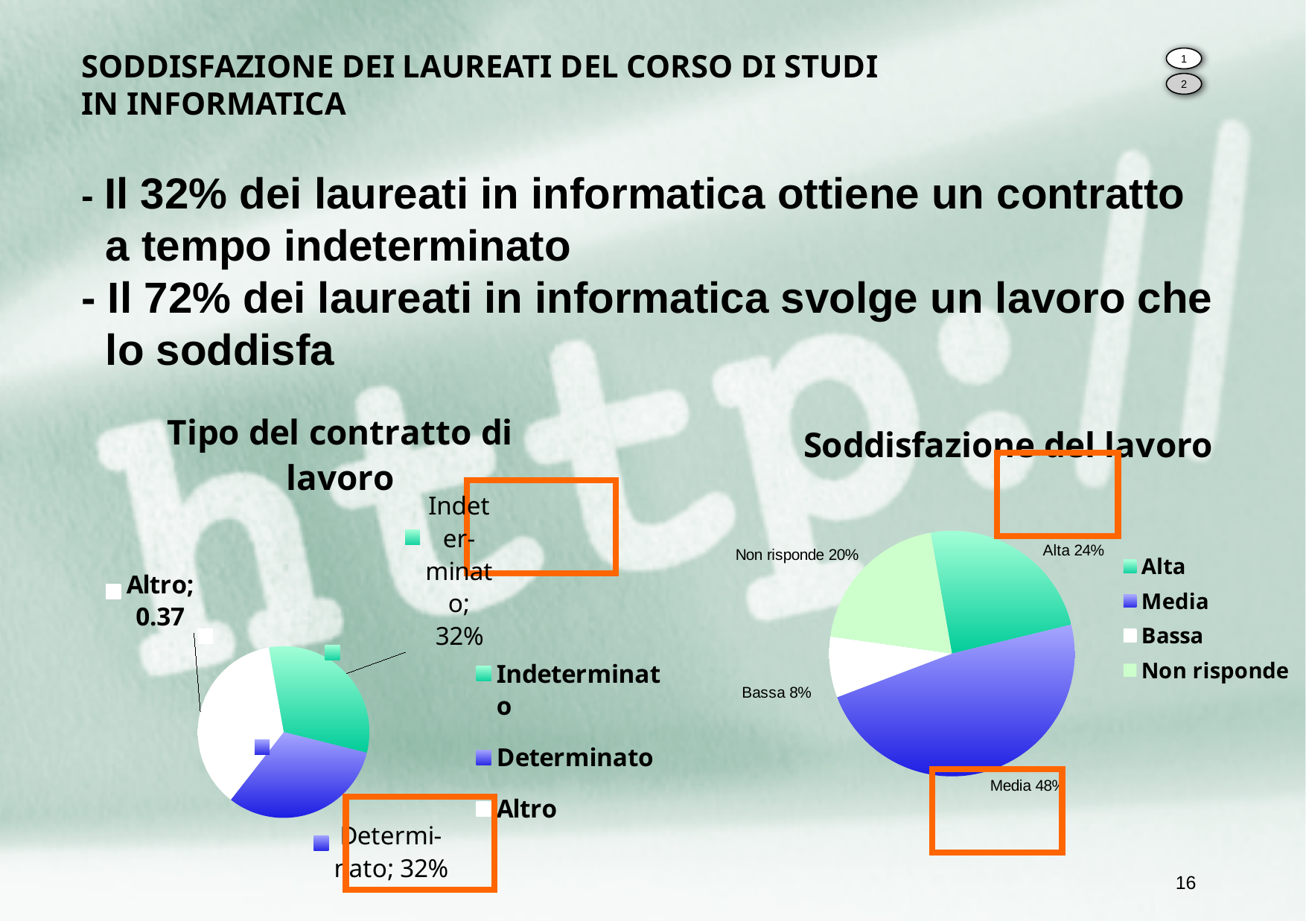
In the 'Soddisfazione del lavoro' chart, what percentage is labelled for Bassa? 8% In the 'Soddisfazione del lavoro' chart, which is larger, Alta or Non risponde? Alta In the 'Soddisfazione del lavoro' chart, what percentage is labelled for Non risponde? 20% In the 'Tipo del contratto di lavoro' chart, what value is labelled for Indeterminato? 32% In the 'Soddisfazione del lavoro' chart, which category has the smallest slice? Bassa How many categories does the legend of the 'Tipo del contratto di lavoro' chart list? 3 In the 'Soddisfazione del lavoro' chart, what percentage is labelled for Media? 48% In the 'Tipo del contratto di lavoro' chart, what value is labelled for Altro? 0.37 How many categories does the legend of the 'Soddisfazione del lavoro' chart list? 4 What type of chart is the 'Tipo del contratto di lavoro' chart? Pie chart In the 'Soddisfazione del lavoro' chart, what is the difference between the Media and Alta percentages? 24% In the 'Soddisfazione del lavoro' chart, which category has the largest slice? Media